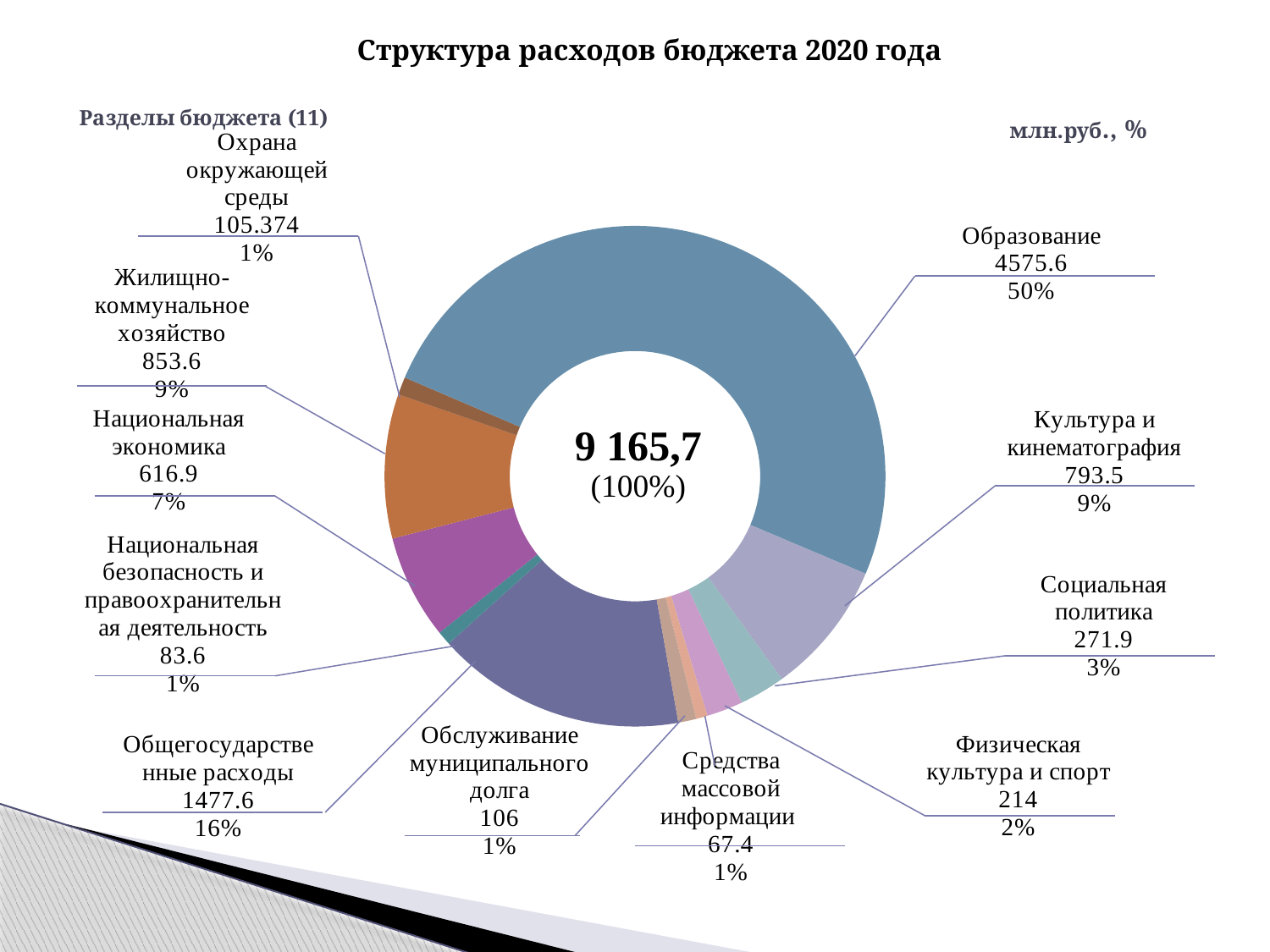
What total value is shown in the centre of the chart? 9 165,7 What kind of chart is shown on the slide? doughnut chart What is the difference between the values for Образование and Общегосударственные расходы? 3098 Which is larger, Национальная экономика or Социальная политика? Национальная экономика Which category has the highest value? Образование What is the value for Общегосударственные расходы? 1477.6 What share of the total does Общегосударственные расходы account for? 16% Which category has the lowest value? Средства массовой информации What share of the total does Культура и кинематография account for? 9% What is the value for Образование? 4575.6 What is the value for Охрана окружающей среды? 105.374 How many categories are shown in the chart? 11